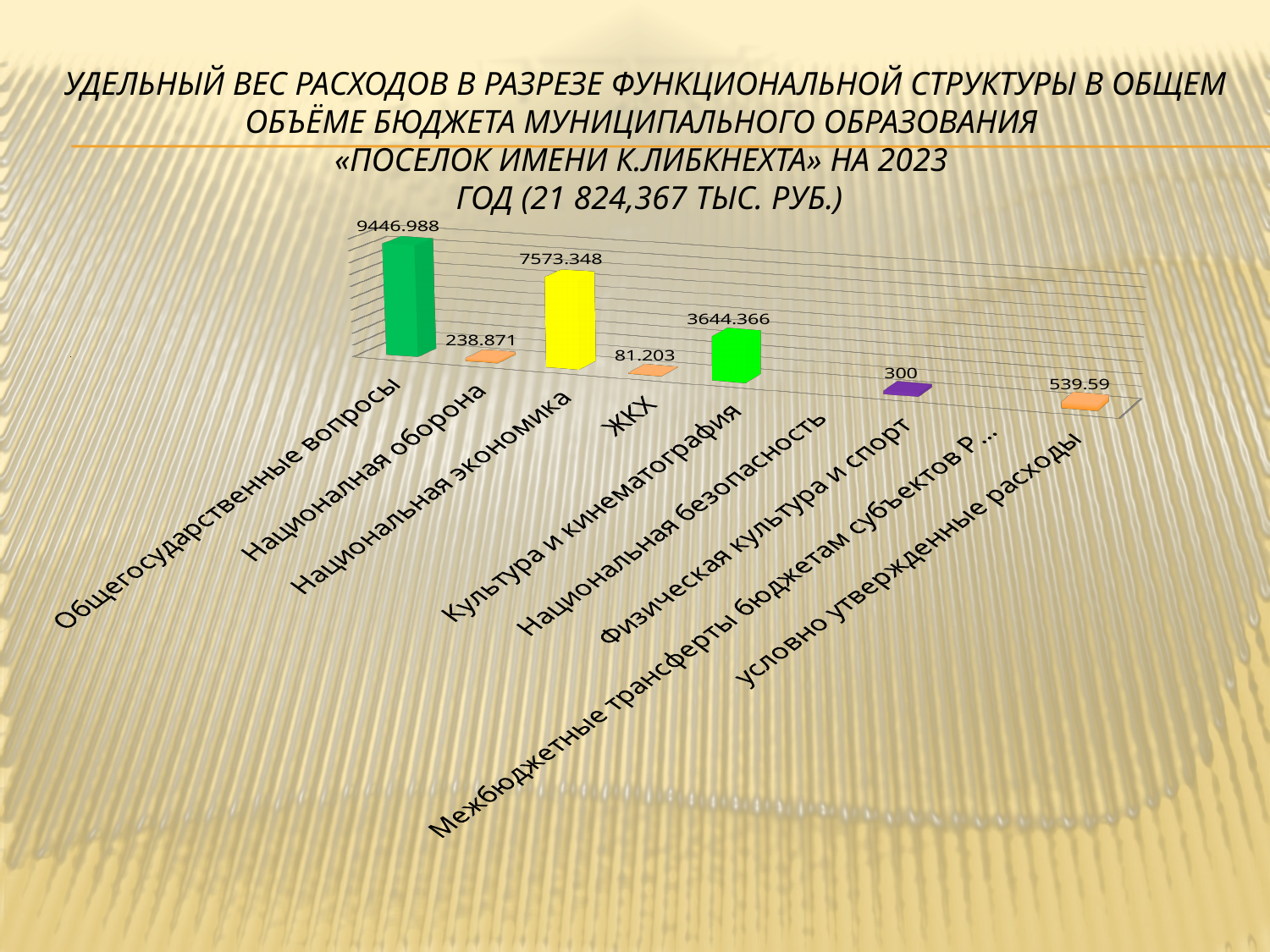
What is the value for ЖКХ? 81.203 What is the value for Общегосударственные вопросы? 9446.988 What is the difference between the values for Общегосударственные вопросы and Национальная экономика? 1873.64 What is the value for Национальная оборона? 238.871 Which is larger, the value for Культура и кинематография or the value for Национальная оборона? Культура и кинематография What is the value for Культура и кинематография? 3644.366 What is the value for Национальная экономика? 7573.348 How many categories are shown on the x axis? 9 What is the value for условно утвержденные расходы? 539.59 Which category has the highest value? Общегосударственные вопросы Which labelled category has the lowest value? ЖКХ What kind of chart is shown on the slide? Bar chart